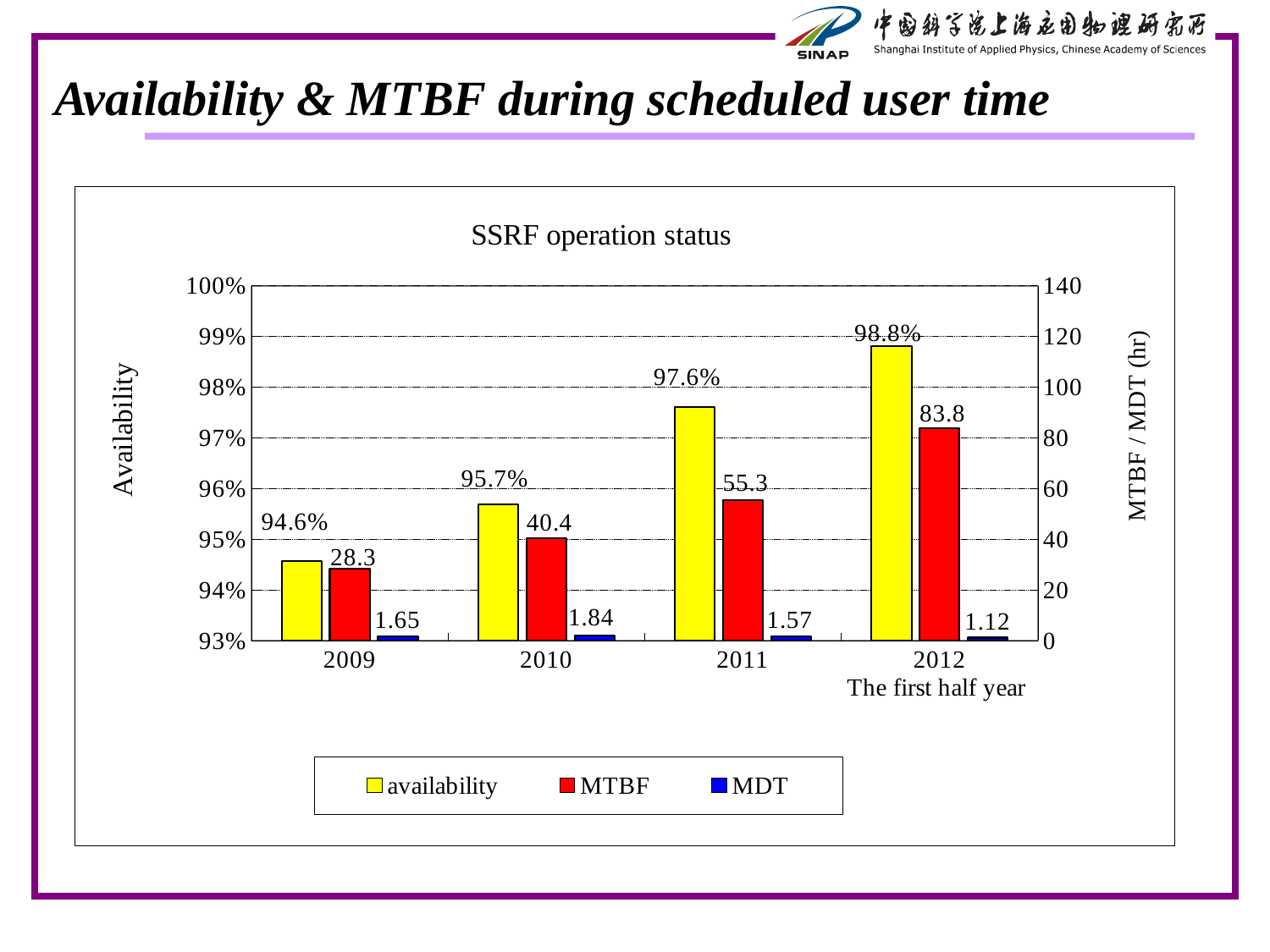
What is the difference in MTBF between 2012 and 2011? 28.5 How many series does the legend list? 3 What kind of chart is shown? bar chart Which year has the highest availability? 2012 What is the title of the chart? SSRF operation status What is the MTBF value for 2011? 55.3 Which year has the larger MDT value, 2010 or 2011? 2010 What is the MDT value for 2012? 1.12 Which year has the lowest MTBF? 2009 How many years are shown on the x axis? 4 What is the availability value for 2010? 95.7% Does availability rise or fall from 2009 to 2012? rise